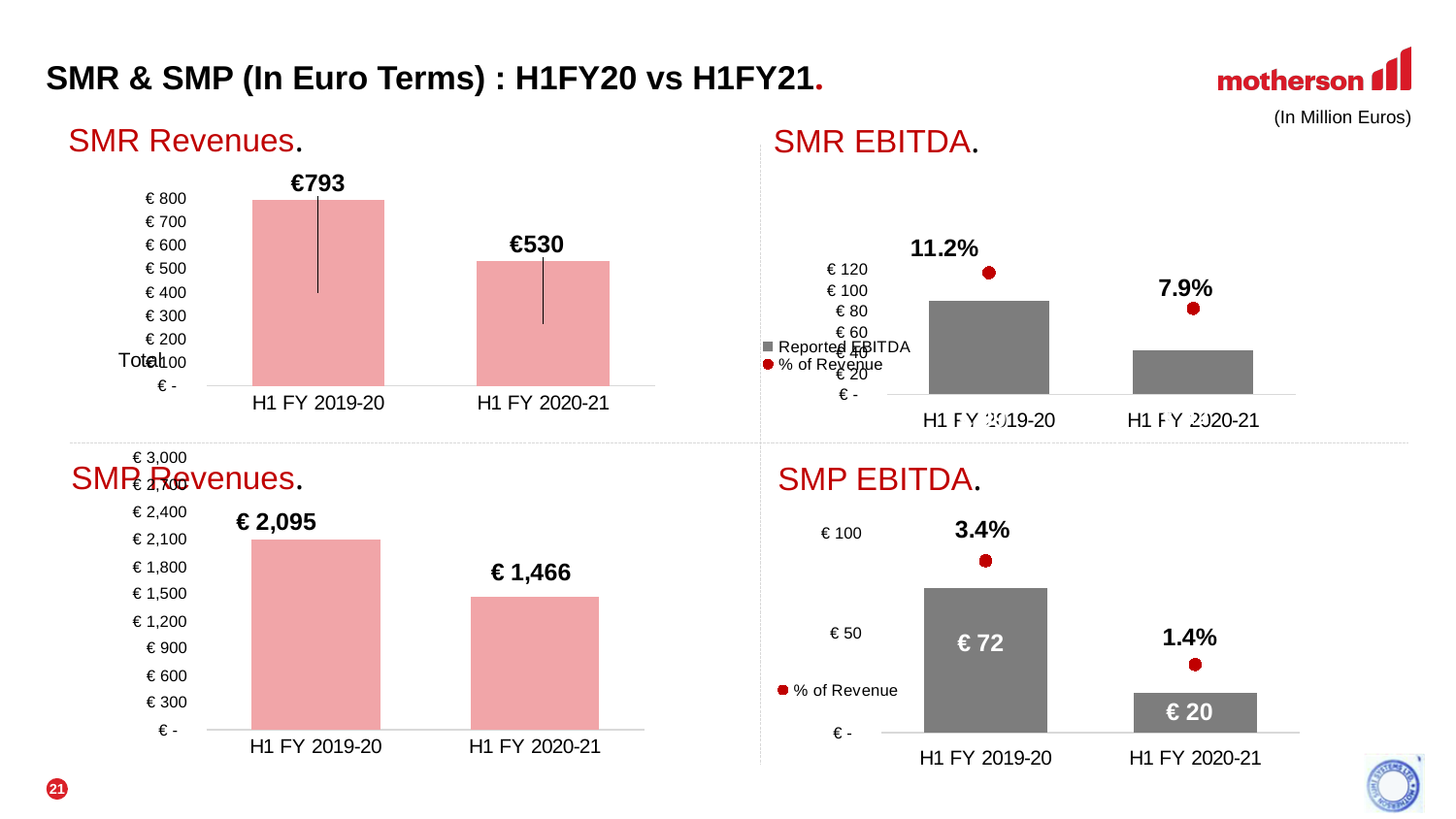
In the SMR EBITDA chart, is the Reported EBITDA bar for H1 FY 2020-21 greater or less than € 60? less In the SMR Revenues chart, do the values rise or fall from H1 FY 2019-20 to H1 FY 2020-21? fall In the SMR Revenues chart, what is the value for H1 FY 2019-20? €793 In the SMP EBITDA chart, what is the EBITDA value for H1 FY 2019-20? € 72 In the SMP Revenues chart, what is the value for H1 FY 2019-20? € 2,095 In the SMP Revenues chart, what is the value for H1 FY 2020-21? € 1,466 In the SMP Revenues chart, which period has the higher revenue? H1 FY 2019-20 In the SMP EBITDA chart, what is the % of Revenue for H1 FY 2020-21? 1.4% In the SMR Revenues chart, what is the difference between the H1 FY 2019-20 and H1 FY 2020-21 values? €263 What kind of chart is the SMP Revenues chart? bar chart In the SMR EBITDA chart, what is the % of Revenue for H1 FY 2019-20? 11.2% In the SMR Revenues chart, what is the value for H1 FY 2020-21? €530